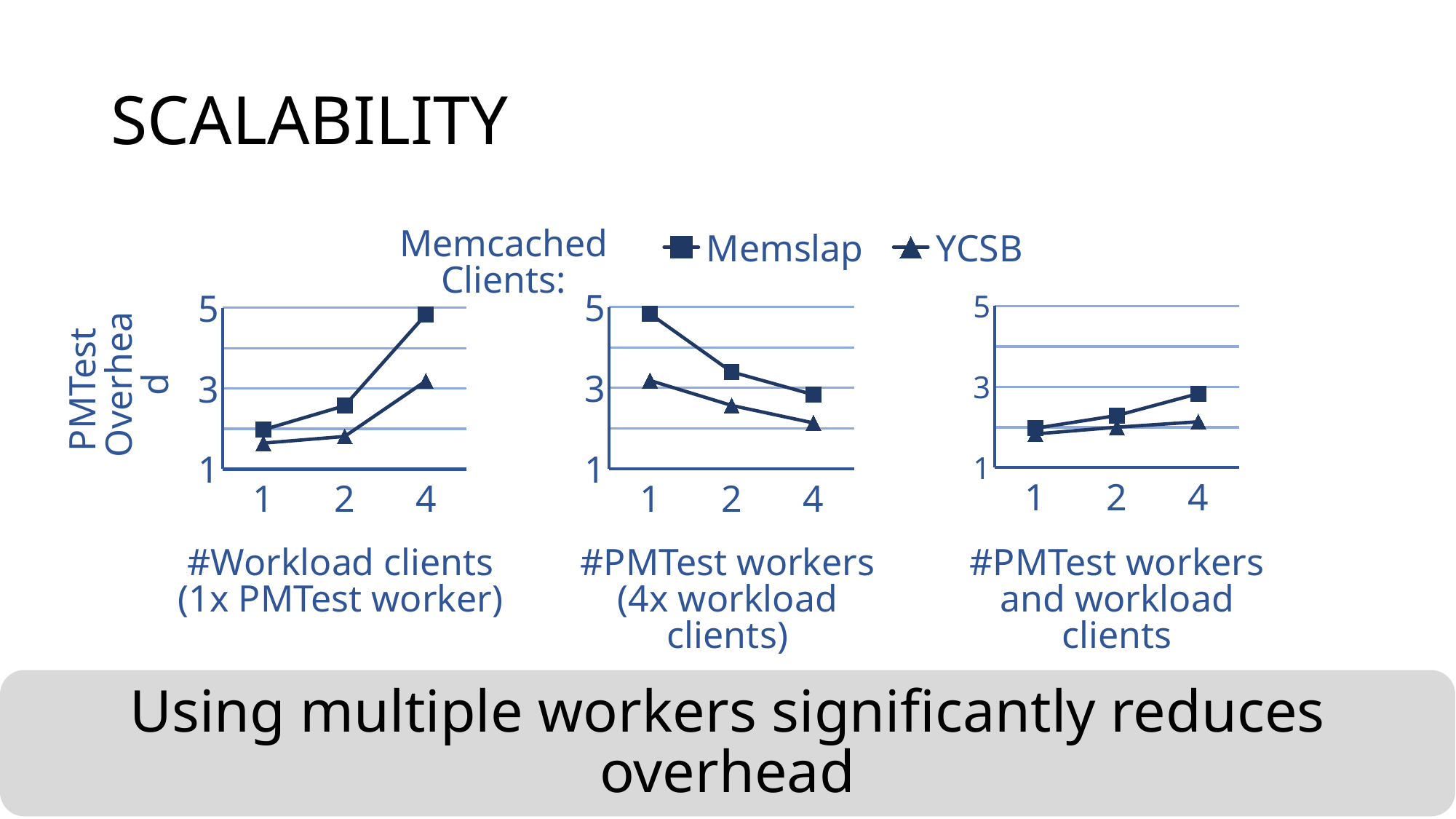
In the middle chart (#PMTest workers, 4x workload clients), does the Memslap overhead rise or fall as the number of PMTest workers increases? fall In the middle chart (#PMTest workers, 4x workload clients), is the Memslap value at 1 PMTest worker greater or less than 3? greater What kind of chart is the left chart, titled "#Workload clients (1x PMTest worker)"? line chart In the left chart (#Workload clients, 1x PMTest worker), which series has the higher value at 4 workload clients, Memslap or YCSB? Memslap In the left chart (#Workload clients, 1x PMTest worker), is the Memslap value at 4 workload clients greater or less than 3? greater In the middle chart (#PMTest workers, 4x workload clients), which series has the lower value at 1 PMTest worker, Memslap or YCSB? YCSB In the middle chart (#PMTest workers, 4x workload clients), is the YCSB value at 4 PMTest workers greater or less than 3? less Which two series are listed in the legend? Memslap and YCSB In the left chart (#Workload clients, 1x PMTest worker), does the Memslap overhead rise or fall as the number of workload clients increases? rise In the left chart (#Workload clients, 1x PMTest worker), how many x-axis points are plotted for each series? 3 How many series does the legend list for the charts? 2